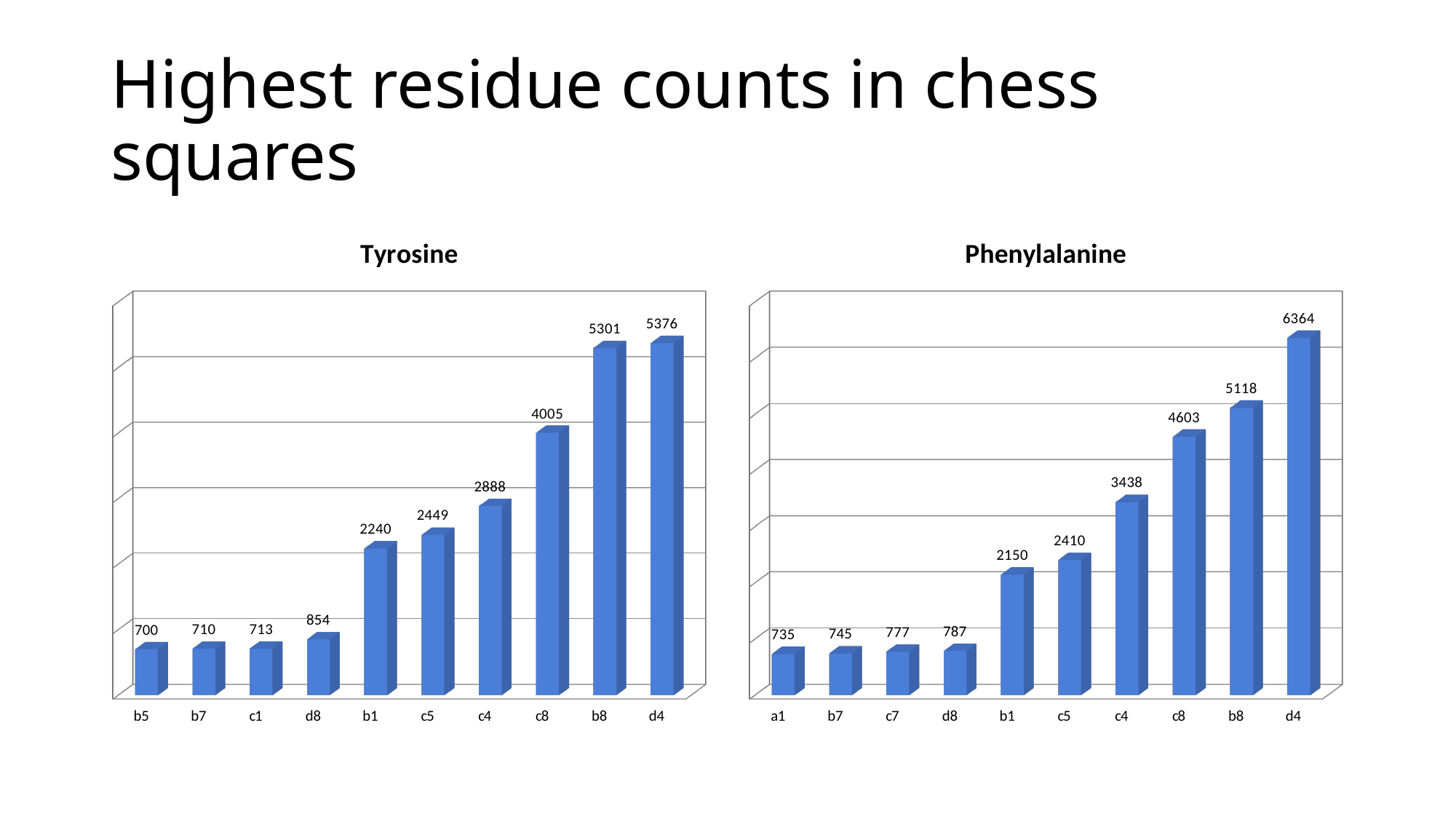
In the Phenylalanine chart, which is larger, the value for b1 or the value for c5? c5 In the Phenylalanine chart, what is the difference between the values for d4 and b8? 1246 What kind of chart is the Phenylalanine chart? bar chart In the Tyrosine chart, what is the value for c8? 4005 What is the title of the chart on the right side of the slide? Phenylalanine In the Tyrosine chart, do the values rise or fall from left to right along the x axis? rise How many squares are shown in the Tyrosine chart? 10 In the Tyrosine chart, which square has the highest value? d4 In the Phenylalanine chart, which square has the lowest value? a1 In the Phenylalanine chart, what is the value for c4? 3438 In the Tyrosine chart, what is the difference between the values for d4 and b8? 75 In the Tyrosine chart, what is the value for b1? 2240